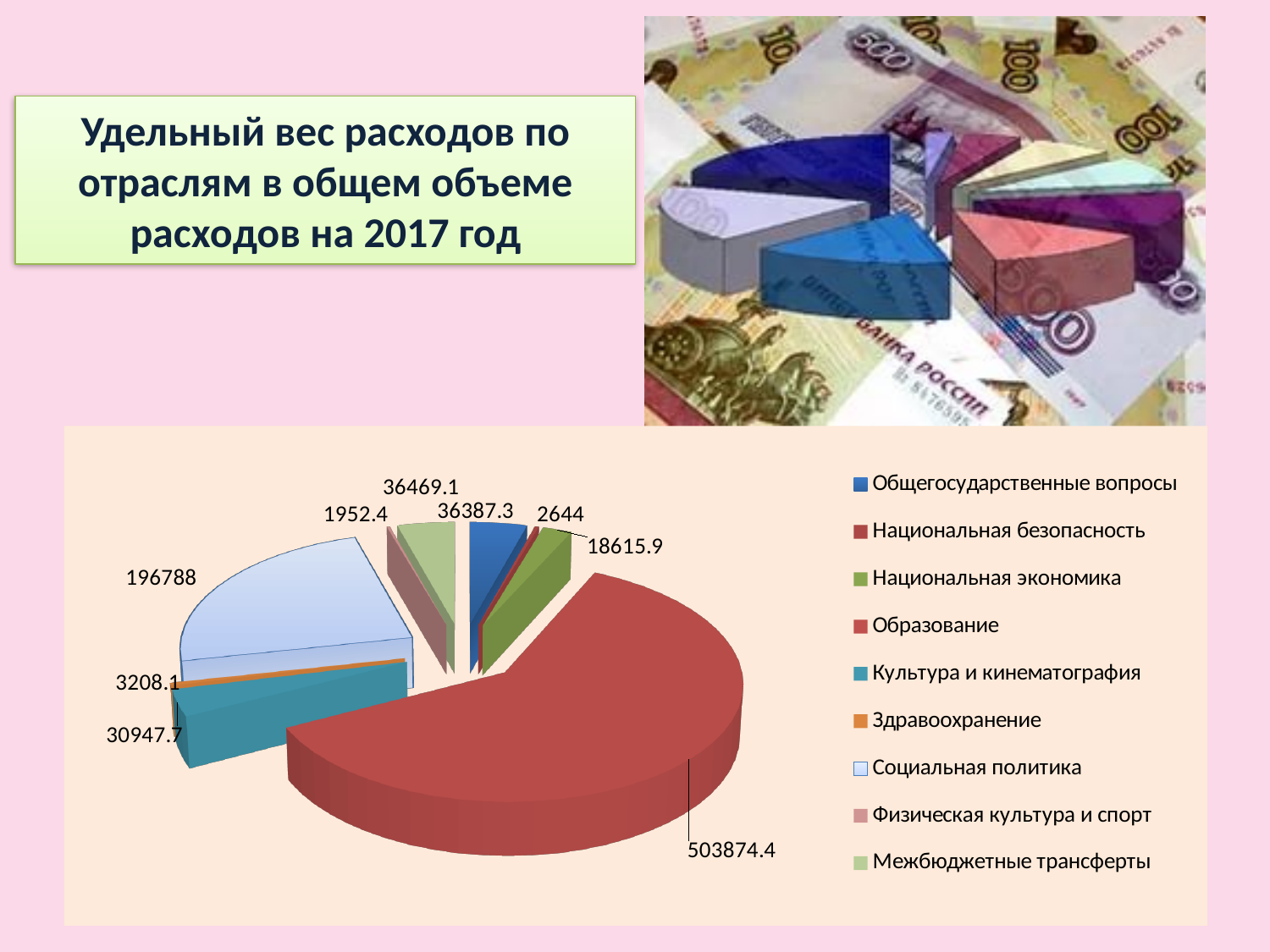
What is the value shown for Образование? 503874.4 What is the value shown for Здравоохранение? 3208.1 Which is larger, the value for Социальная политика or the value for Культура и кинематография? Социальная политика How many categories does the legend of the pie chart list? 9 What is the value shown for Социальная политика? 196788 Which category has the smallest value in the pie chart? Физическая культура и спорт What is the title shown in the text box on the slide? Удельный вес расходов по отраслям в общем объеме расходов на 2017 год What kind of chart is shown on the slide? Pie chart What share of the total does the Образование slice represent? 60.6% Which category has the largest slice in the pie chart? Образование What is the value shown for Культура и кинематография? 30947.7 What is the difference between the values for Образование and Социальная политика? 307086.4